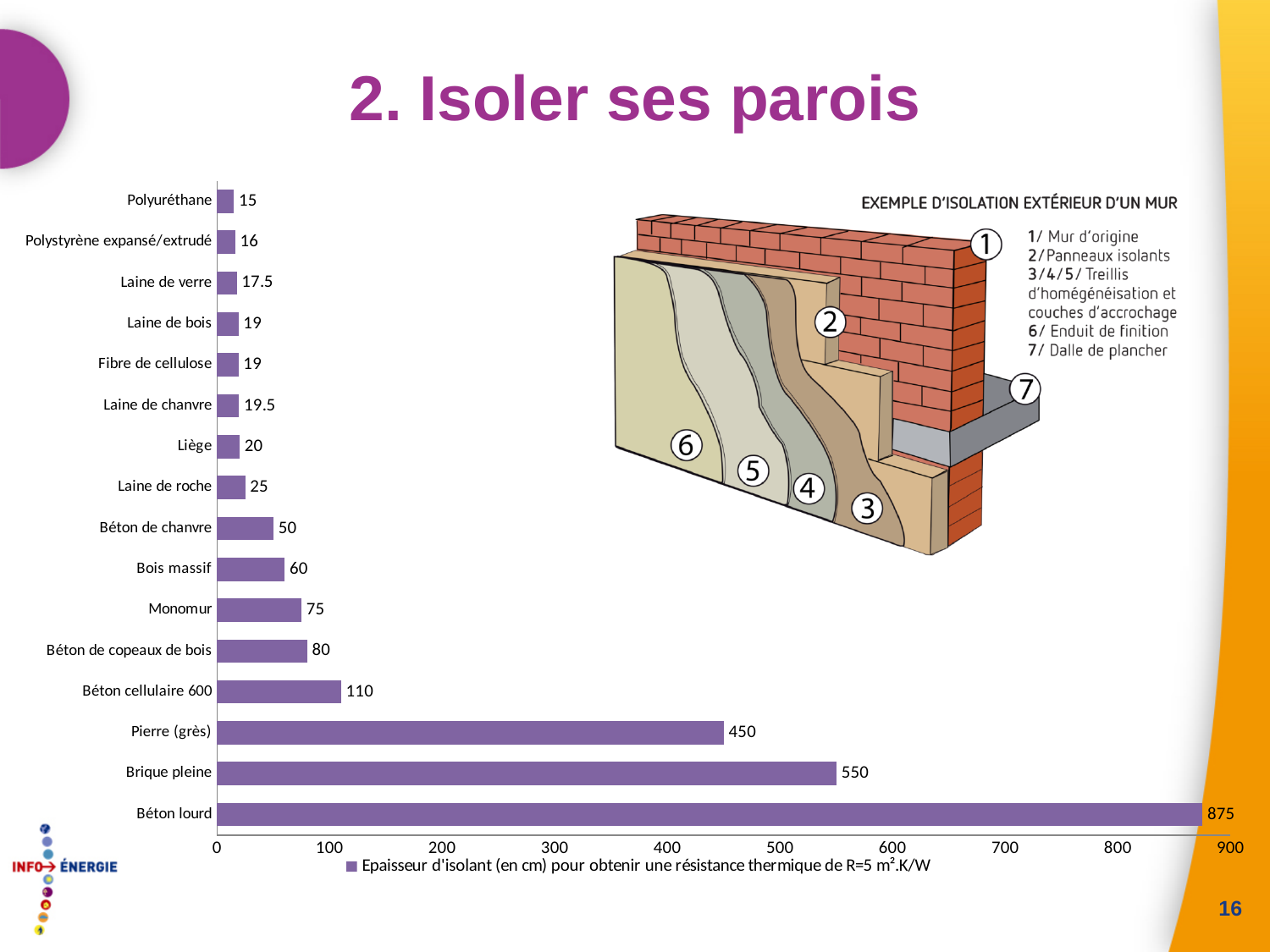
Which category has the highest value? Béton lourd What is the value for Béton lourd? 875 What is the value for Pierre (grès)? 450 Which category has the lowest value? Polyuréthane Is the value for Béton cellulaire 600 greater or less than 100? greater What is the value for Laine de verre? 17.5 How many series does the legend list? 1 Which is larger, the value for Monomur or the value for Bois massif? Monomur What kind of chart is shown on the slide? bar chart What is the difference between the values for Brique pleine and Pierre (grès)? 100 What is the value for Béton de chanvre? 50 How many categories are shown in the bar chart? 16